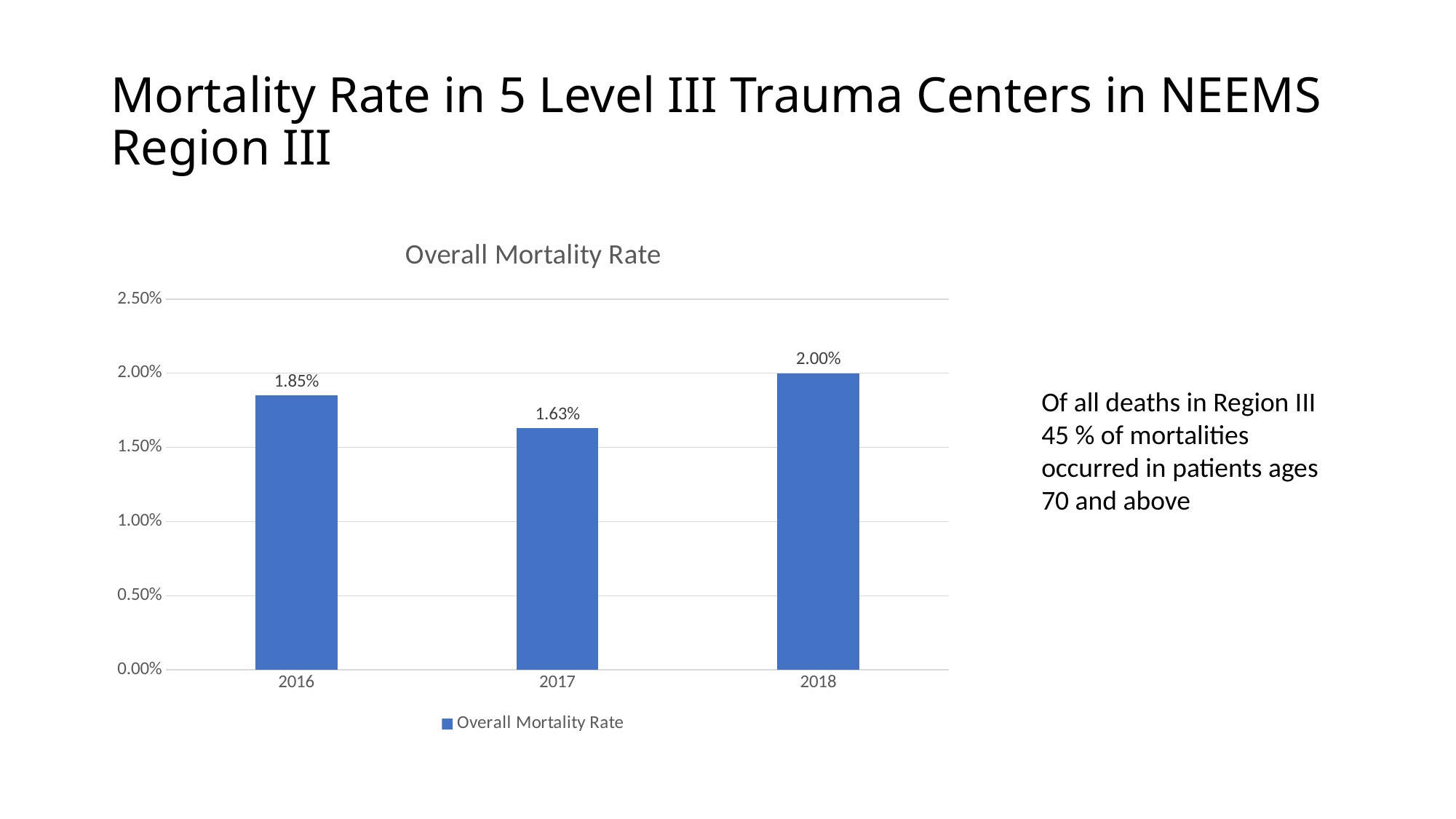
What is the difference between the overall mortality rate in 2016 and in 2017? 0.22% Is the overall mortality rate for 2017 greater or less than 2.00%? less What is the title of the chart? Overall Mortality Rate What is the overall mortality rate for 2017? 1.63% Which year has a higher overall mortality rate, 2016 or 2018? 2018 What is the overall mortality rate for 2018? 2.00% What is the overall mortality rate for 2016? 1.85% How many years are shown on the x axis of the chart? 3 Which year has the lowest overall mortality rate? 2017 What kind of chart is shown on the slide? bar chart Which year has the highest overall mortality rate? 2018 What is the difference between the overall mortality rate in 2018 and in 2017? 0.37%